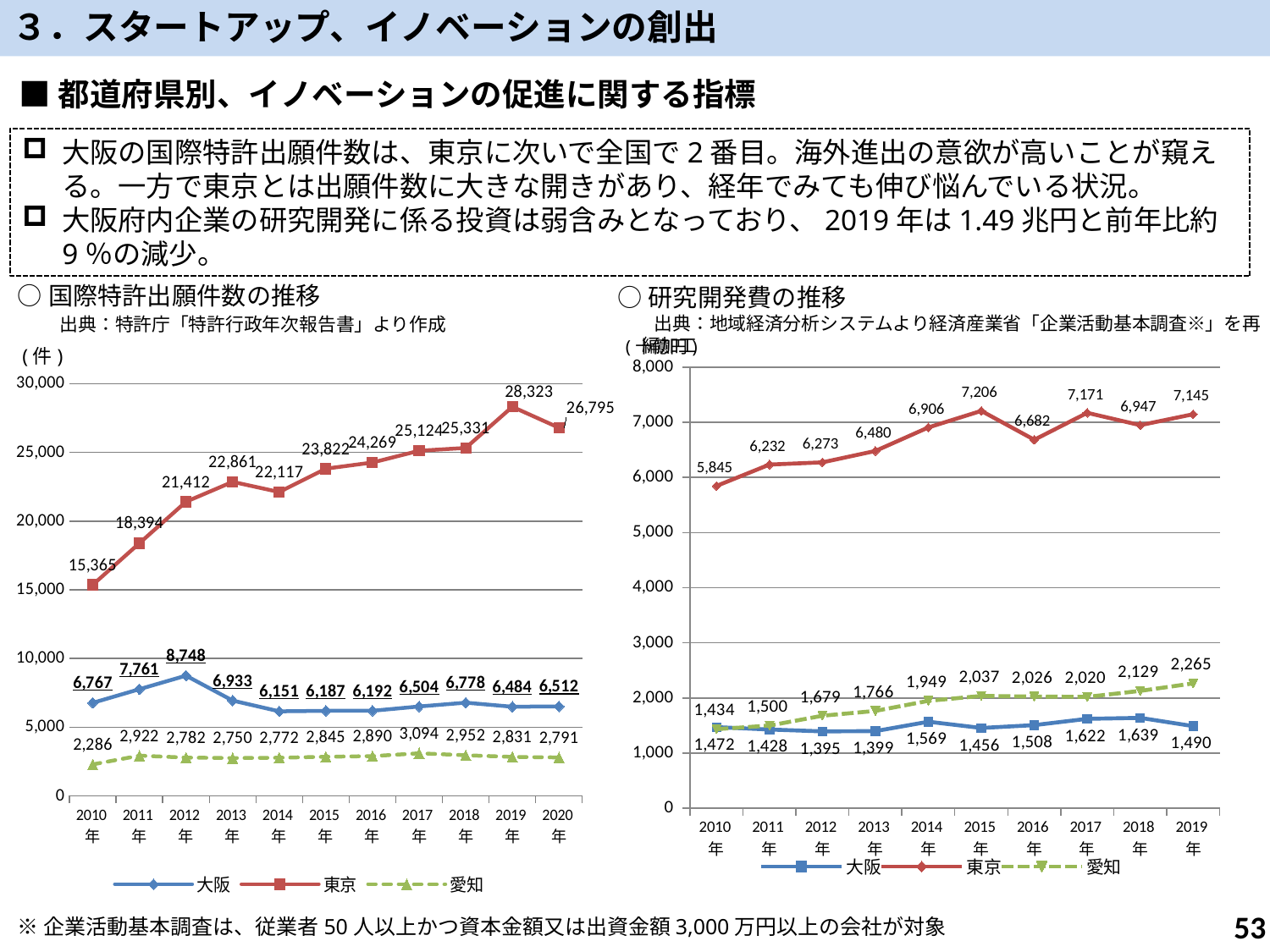
「研究開発費の推移」のグラフで、2019年の大阪の値はいくつですか？ 1,490 「国際特許出願件数の推移」のグラフで、2010年の愛知の値はいくつですか？ 2,286 「国際特許出願件数の推移」のグラフには何年分のデータ点がありますか？ 11 「研究開発費の推移」のグラフで、2010年の東京の値はいくつですか？ 5,845 「研究開発費の推移」のグラフで、東京の値が最も高いのは何年ですか？ 2015年 「国際特許出願件数の推移」のグラフで、東京の値は2010年から2019年にかけて増加していますか、減少していますか？ 増加 「研究開発費の推移」のグラフはどの種類のグラフですか？ 折れ線グラフ 「国際特許出願件数の推移」のグラフで、大阪の値が最も高いのは何年ですか？ 2012年 「国際特許出願件数の推移」のグラフで、2020年の東京の値はいくつですか？ 26,795 「国際特許出願件数の推移」のグラフで、2019年の東京と大阪の差はいくつですか？ 21,839 「研究開発費の推移」のグラフの凡例には何系列ありますか？ 3 「研究開発費の推移」のグラフで、2019年の愛知と大阪ではどちらの値が大きいですか？ 愛知